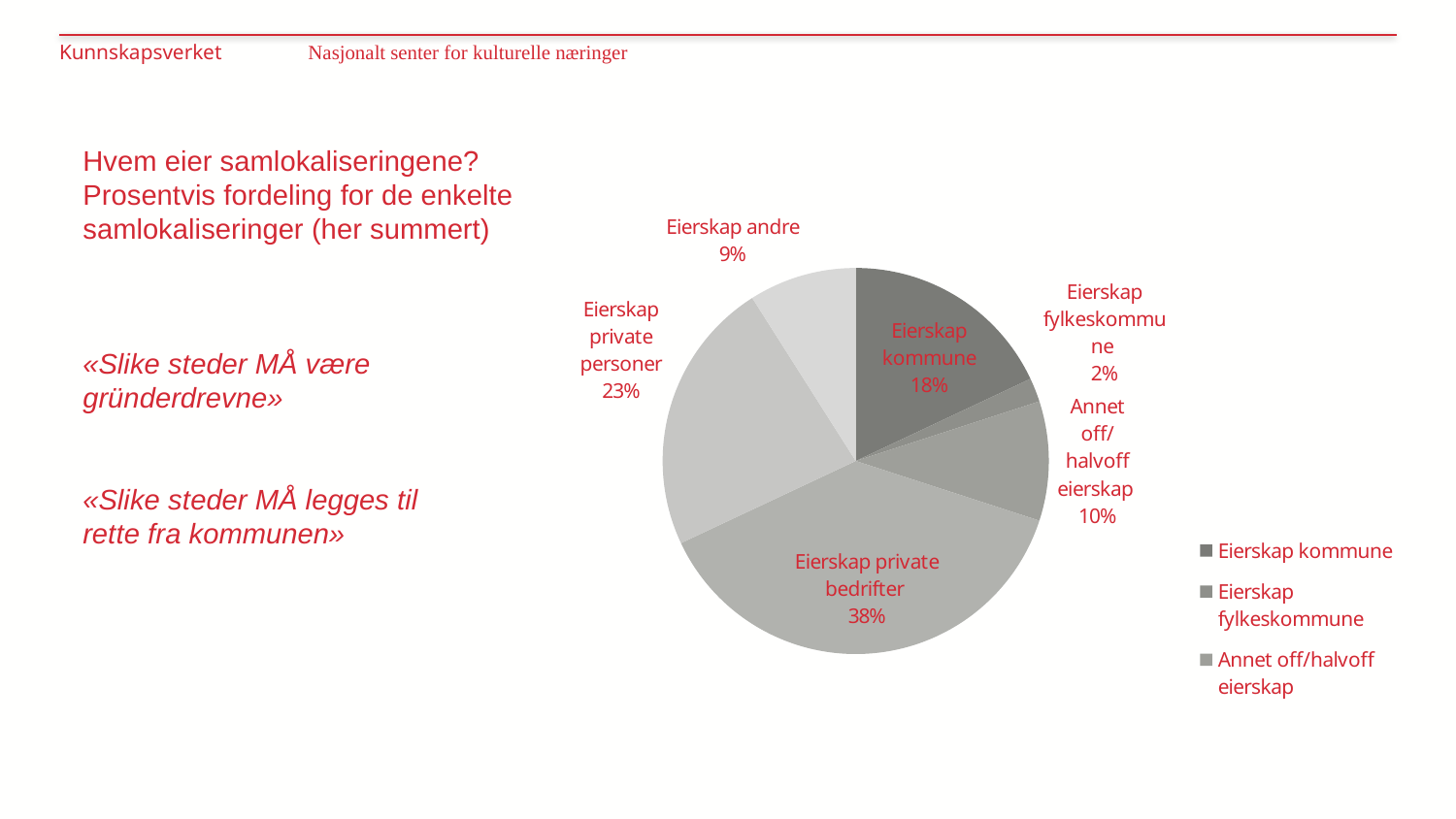
Which slice of the pie is the largest? Eierskap private bedrifter What percentage is shown for "Eierskap kommune"? 18% Which slice of the pie is the smallest? Eierskap fylkeskommune How many entries are listed in the legend shown on the slide? 3 What percentage is shown for "Eierskap andre"? 9% How many slices does the pie chart have? 6 What share of the pie is labelled "Eierskap private bedrifter"? 38% What percentage is shown for "Eierskap private personer"? 23% Which is larger, "Eierskap kommune" or "Annet off/halvoff eierskap"? Eierskap kommune What is the difference in percentage points between "Eierskap private bedrifter" and "Eierskap private personer"? 15 What percentage is shown for "Annet off/halvoff eierskap"? 10% What kind of chart is shown on the slide? Pie chart